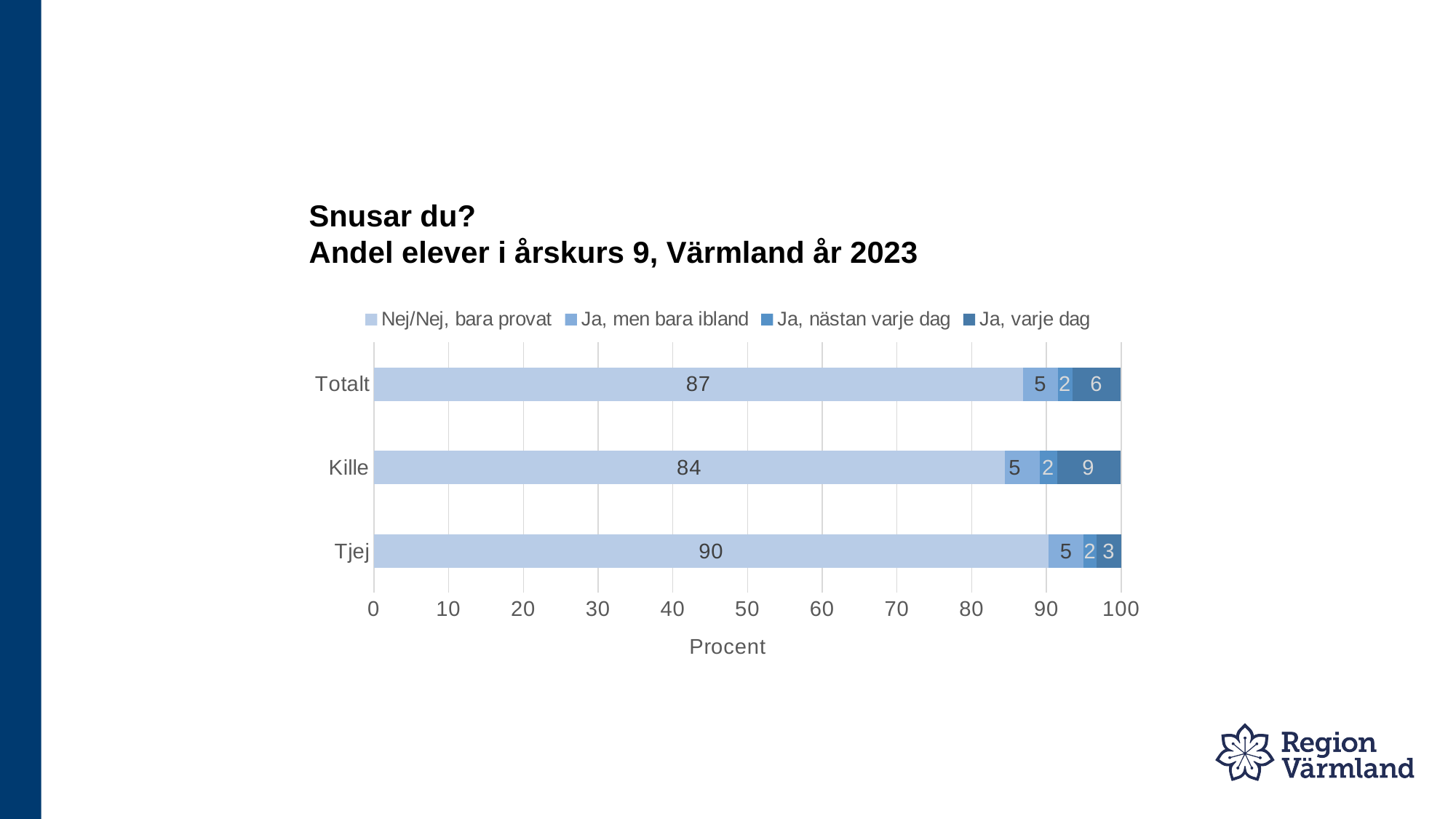
What is the difference between the "Ja, varje dag" values for Kille and Tjej? 6 Which is larger: the "Nej/Nej, bara provat" value for Kille or for Totalt? Totalt What is the value for "Nej/Nej, bara provat" in the Tjej bar? 90 What is the value for "Nej/Nej, bara provat" in the Totalt bar? 87 What is the value for "Ja, varje dag" in the Tjej bar? 3 Which category has the lowest value for "Ja, varje dag"? Tjej What is the total of the stacked bar for Kille? 100 How many series does the legend list? 4 How many categories are shown on the y axis? 3 What kind of chart is shown on the slide? Stacked bar chart Which category has the highest value for "Nej/Nej, bara provat"? Tjej What is the value for "Ja, varje dag" in the Kille bar? 9